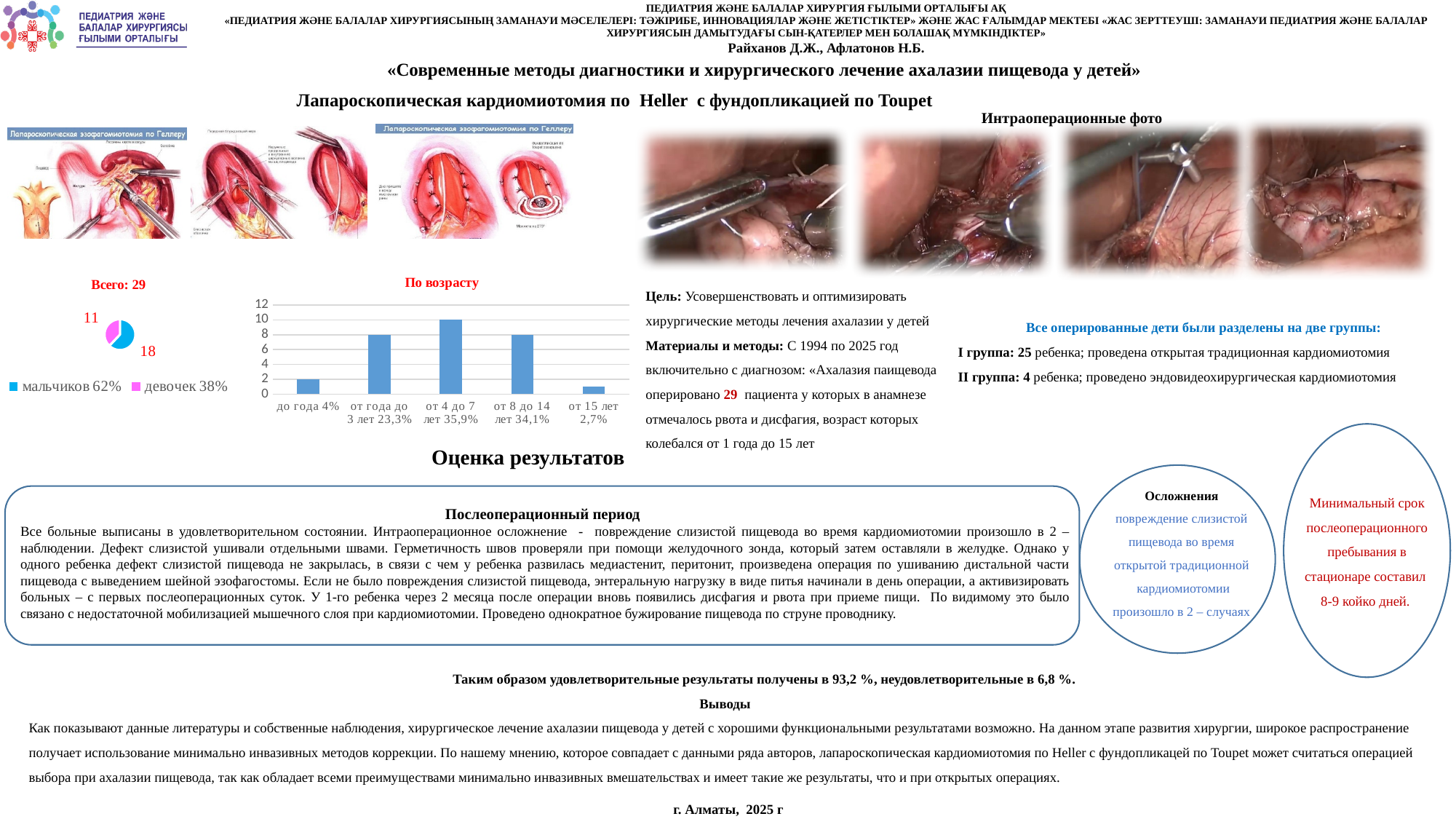
In the pie chart «Всего: 29», what share of the pie is мальчиков? 62% What kind of chart is the chart titled «По возрасту»? bar chart In the bar chart «По возрасту», what is the value for «от 4 до 7 лет 35,9%»? 10 In the bar chart «По возрасту», which age category has the lowest bar? от 15 лет 2,7% How many age categories are shown in the bar chart «По возрасту»? 5 In the pie chart «Всего: 29», what share of the pie is девочек? 38% In the pie chart «Всего: 29», how many девочек are shown? 11 In the pie chart «Всего: 29», how many мальчиков are shown? 18 What kind of chart is the chart titled «Всего: 29»? pie chart In the bar chart «По возрасту», is the value for «от 15 лет 2,7%» greater or less than 2? less In the bar chart «По возрасту», which age category has the highest bar? от 4 до 7 лет 35,9% In the pie chart «Всего: 29», which slice is larger, мальчиков or девочек? мальчиков